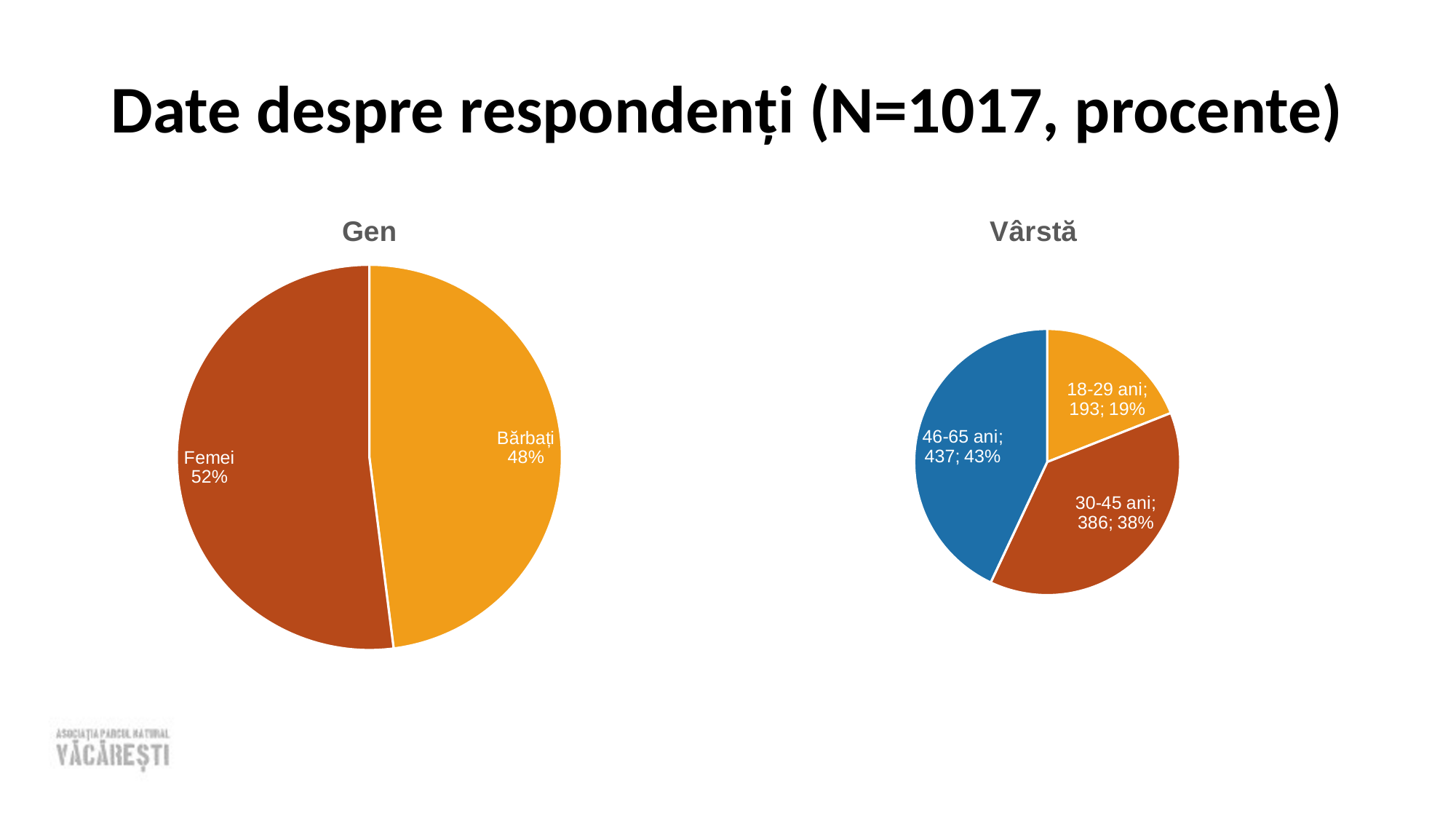
What kind of chart is the 'Gen' chart? Pie chart In the 'Gen' chart, which category has the larger share? Femei In the 'Gen' chart, what is the difference in percentage points between Femei and Bărbați? 4 In the 'Vârstă' chart, what percentage of respondents are 30-45 ani? 38% In the 'Vârstă' chart, what is the difference in number of respondents between the 46-65 ani and 30-45 ani groups? 51 In the 'Gen' chart, what percentage of respondents are Bărbați? 48% In the 'Vârstă' chart, which age group has the largest share? 46-65 ani In the 'Vârstă' chart, how many age groups are shown? 3 In the 'Vârstă' chart, how many respondents are in the 46-65 ani group? 437 In the 'Gen' chart, what percentage of respondents are Femei? 52% In the 'Vârstă' chart, how many respondents are in the 18-29 ani group? 193 In the 'Vârstă' chart, which age group has the smallest share? 18-29 ani